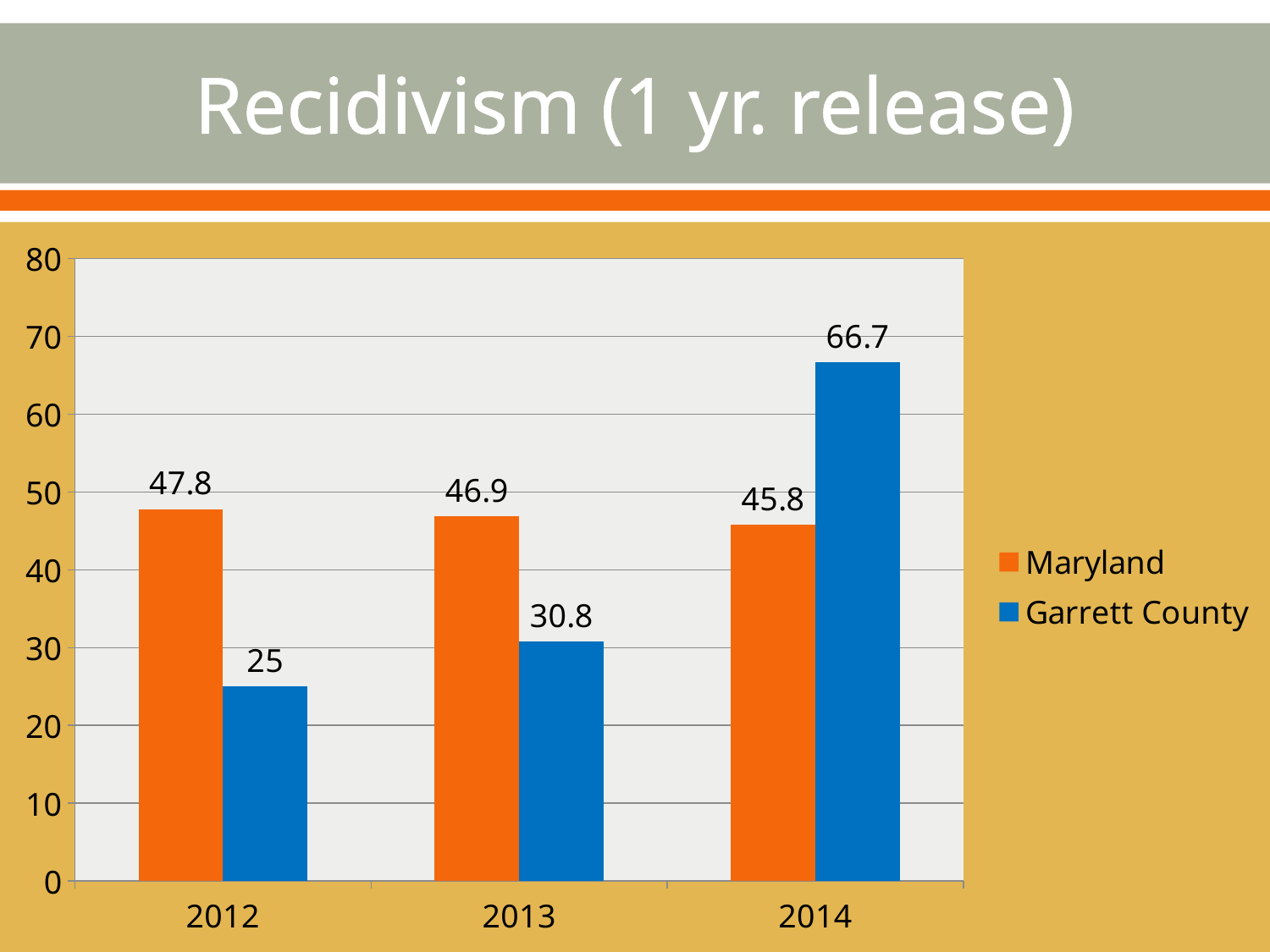
What is the title of the slide? Recidivism (1 yr. release) What is the difference between the Garrett County and Maryland values in 2014? 20.9 In which year is the Garrett County value lowest? 2012 Do the Garrett County values rise or fall from 2012 to 2014? Rise How many series does the legend list? 2 In which year is the Garrett County value highest? 2014 What is the Garrett County value for 2013? 30.8 What is the Garrett County value for 2014? 66.7 What kind of chart is shown on the slide? Bar chart What is the Maryland value for 2012? 47.8 How many years are shown on the x axis? 3 Which is larger in 2012, the Maryland value or the Garrett County value? Maryland